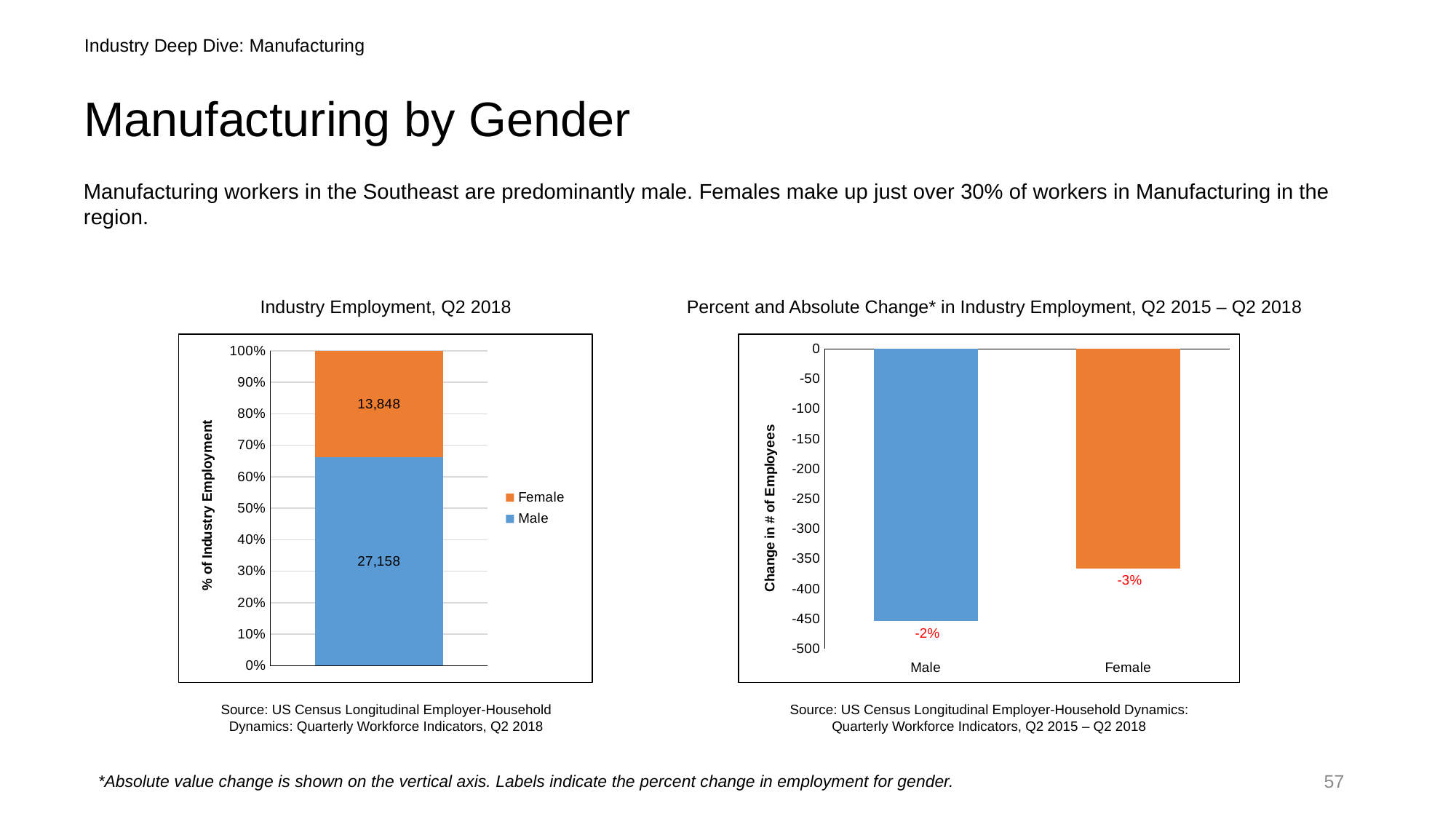
In the 'Industry Employment, Q2 2018' chart, what is the value shown for Female? 13,848 In the 'Percent and Absolute Change in Industry Employment, Q2 2015 – Q2 2018' chart, is the change in number of employees for Female greater or less than -400? greater In the 'Industry Employment, Q2 2018' chart, what is the value shown for Male? 27,158 In the 'Industry Employment, Q2 2018' chart, which segment is larger, Male or Female? Male How many series does the legend of the 'Industry Employment, Q2 2018' chart list? 2 In the 'Percent and Absolute Change in Industry Employment, Q2 2015 – Q2 2018' chart, is the change in number of employees for Male greater or less than -400? less What type of chart is the 'Industry Employment, Q2 2018' chart? Stacked bar chart How many categories are shown on the x axis of the 'Percent and Absolute Change in Industry Employment, Q2 2015 – Q2 2018' chart? 2 In the 'Industry Employment, Q2 2018' chart, what is the difference between the Male and Female values? 13,310 In the 'Percent and Absolute Change in Industry Employment, Q2 2015 – Q2 2018' chart, what percent change label is shown for Male? -2% In the 'Percent and Absolute Change in Industry Employment, Q2 2015 – Q2 2018' chart, what percent change label is shown for Female? -3% In the 'Industry Employment, Q2 2018' chart, what is the total of the stacked bar (Male plus Female)? 41,006